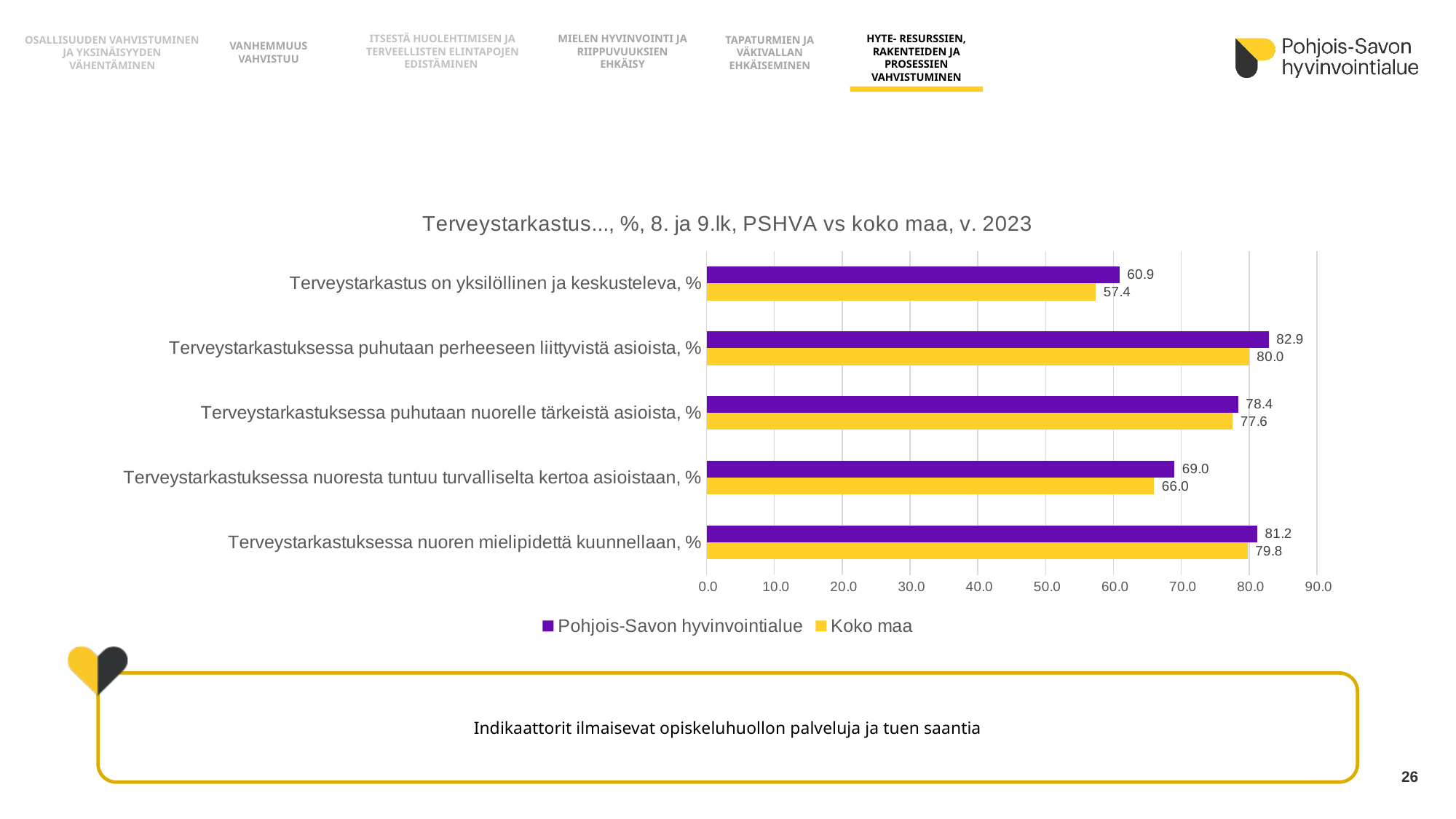
Which category has the highest value for Pohjois-Savon hyvinvointialue? Terveystarkastuksessa puhutaan perheeseen liittyvistä asioista, % What is the difference between Pohjois-Savon hyvinvointialue and Koko maa for 'Terveystarkastuksessa nuoren mielipidettä kuunnellaan, %'? 1.4 Which category has the lowest value for Koko maa? Terveystarkastus on yksilöllinen ja keskusteleva, % What is the value for Koko maa for 'Terveystarkastuksessa puhutaan perheeseen liittyvistä asioista, %'? 80.0 What is the difference between Pohjois-Savon hyvinvointialue and Koko maa for 'Terveystarkastus on yksilöllinen ja keskusteleva, %'? 3.5 What is the title of the chart? Terveystarkastus..., %, 8. ja 9.lk, PSHVA vs koko maa, v. 2023 What is the value for Pohjois-Savon hyvinvointialue for 'Terveystarkastus on yksilöllinen ja keskusteleva, %'? 60.9 For 'Terveystarkastuksessa nuoresta tuntuu turvalliselta kertoa asioistaan, %', which series has the larger value, Pohjois-Savon hyvinvointialue or Koko maa? Pohjois-Savon hyvinvointialue What type of chart is shown on the slide? Bar chart What is the value for Koko maa for 'Terveystarkastuksessa nuoresta tuntuu turvalliselta kertoa asioistaan, %'? 66.0 How many series does the legend list? 2 How many categories are shown on the chart? 5